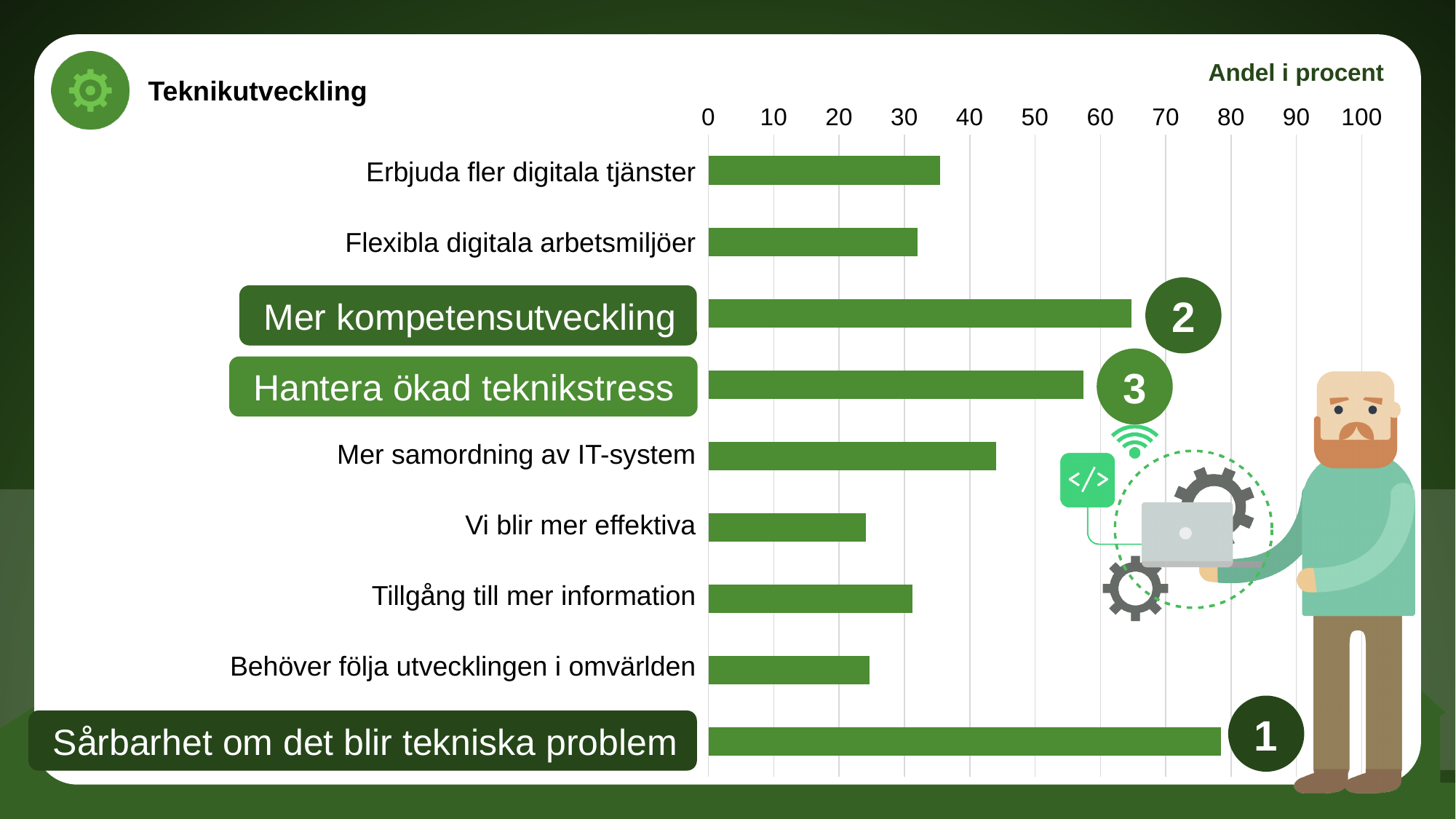
Which category has the highest value? Sårbarhet om det blir tekniska problem Is the value for Mer kompetensutveckling greater or less than 60? greater Which category is marked with the rank badge 3? Hantera ökad teknikstress Is the value for Vi blir mer effektiva greater or less than 30? less Which is larger, the value for Erbjuda fler digitala tjänster or the value for Vi blir mer effektiva? Erbjuda fler digitala tjänster Is the value for Sårbarhet om det blir tekniska problem greater or less than 70? greater What kind of chart is shown on the slide? bar chart Which is larger, the value for Mer kompetensutveckling or the value for Hantera ökad teknikstress? Mer kompetensutveckling How many categories does the chart show? 9 What is the title of the chart? Teknikutveckling